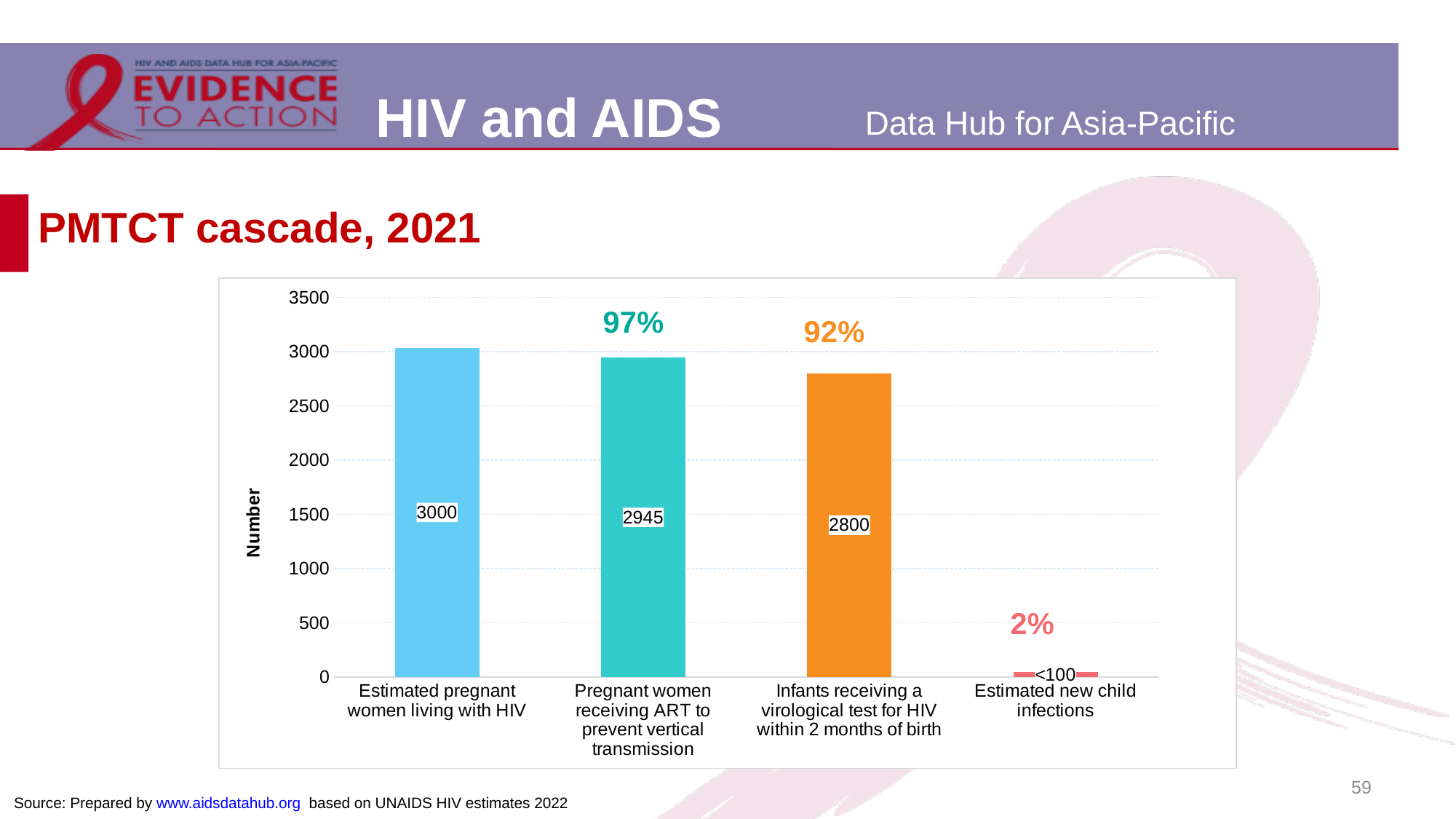
What is the value for Pregnant women receiving ART to prevent vertical transmission? 2945 What label is shown for Estimated new child infections? <100 What kind of chart is shown on the slide? Bar chart What percentage is shown above the bar for Estimated new child infections? 2% Is the value for Infants receiving a virological test for HIV within 2 months of birth greater or less than 2500? greater Which category has the highest value? Estimated pregnant women living with HIV What is the difference between Estimated pregnant women living with HIV and Infants receiving a virological test for HIV within 2 months of birth? 200 What is the value for Infants receiving a virological test for HIV within 2 months of birth? 2800 What percentage is shown above the bar for Pregnant women receiving ART to prevent vertical transmission? 97% Which category has the lowest value? Estimated new child infections What is the value for Estimated pregnant women living with HIV? 3000 How many categories are shown on the x axis? 4